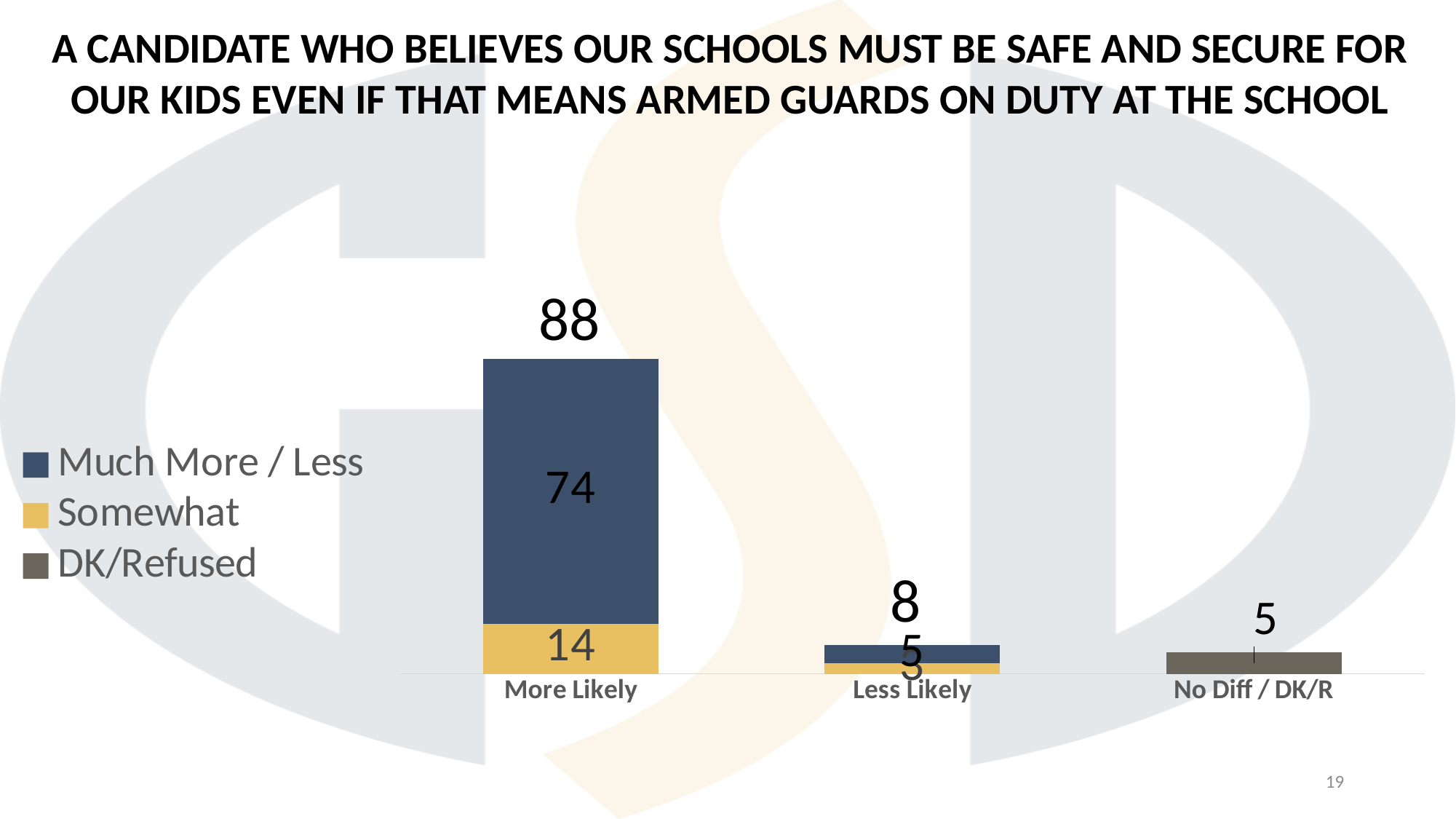
What is the value of the Much More / Less segment for More Likely? 74 How many categories are shown on the x axis? 3 What is the total value of the More Likely bar? 88 What is the difference between the Much More / Less and Somewhat segments in the More Likely bar? 60 What is the total value shown above the Less Likely bar? 8 Which category has the highest total value? More Likely What kind of chart is shown on the slide? Bar chart What is the difference between the More Likely total and the Less Likely total? 80 How many series does the legend list? 3 What is the value of the Somewhat segment for More Likely? 14 What is the value for No Diff / DK/R? 5 Which category has the lowest total value? No Diff / DK/R